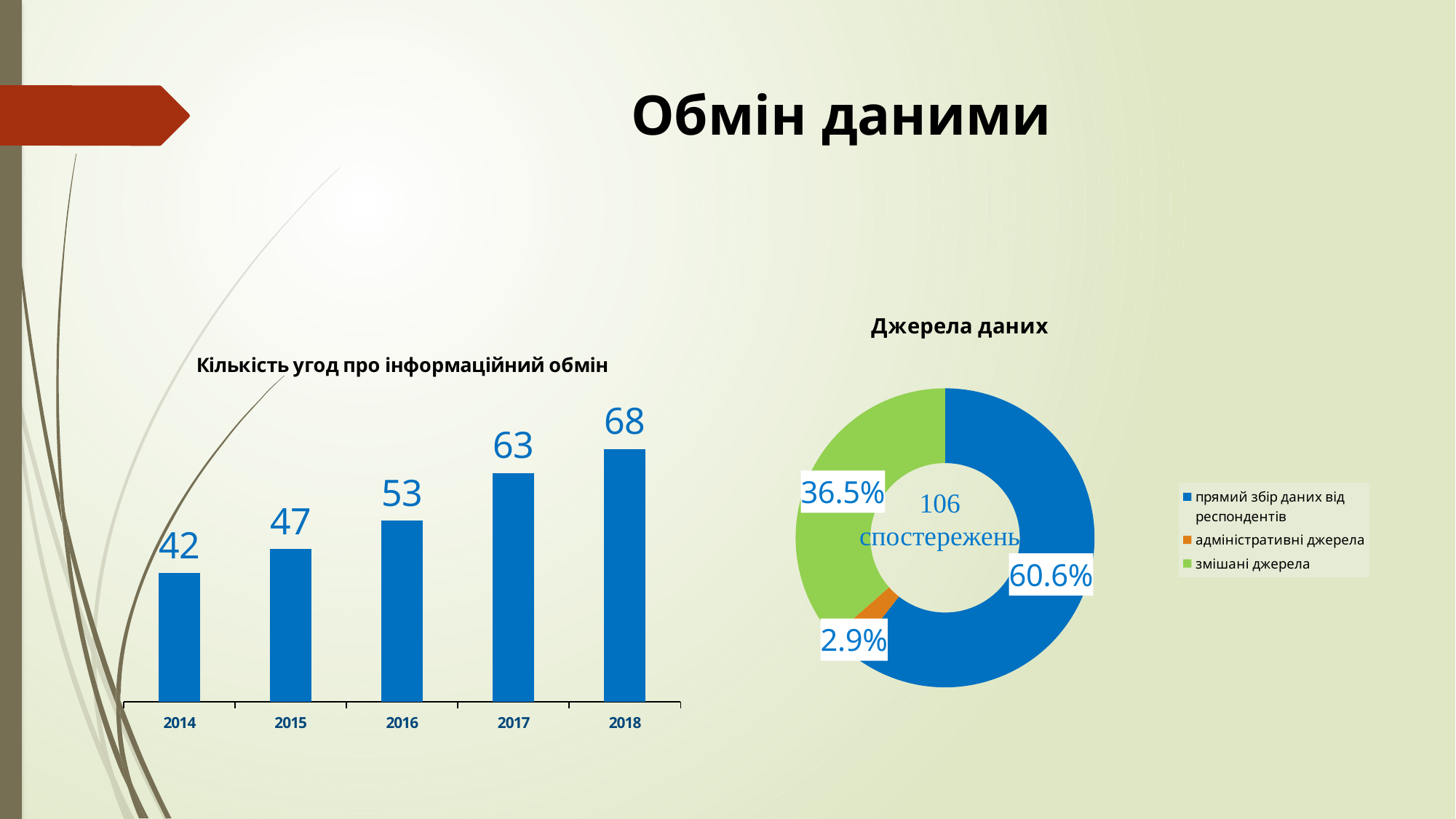
In the chart 'Джерела даних', what number of observations is written in the centre of the doughnut? 106 спостережень What kind of chart is 'Кількість угод про інформаційний обмін'? bar chart In the chart 'Кількість угод про інформаційний обмін', which is larger, the value for 2015 or the value for 2017? 2017 In the chart 'Джерела даних', which source has the smallest share? адміністративні джерела In the chart 'Джерела даних', what share is labelled for 'змішані джерела'? 36.5% In the chart 'Джерела даних', how many entries does the legend list? 3 In the chart 'Кількість угод про інформаційний обмін', do the values rise or fall from 2014 to 2018? rise In the chart 'Кількість угод про інформаційний обмін', how many years are shown on the x axis? 5 In the chart 'Кількість угод про інформаційний обмін', which year has the highest value? 2018 In the chart 'Кількість угод про інформаційний обмін', what is the difference between the values for 2018 and 2014? 26 In the chart 'Кількість угод про інформаційний обмін', which year has the lowest value? 2014 In the chart 'Кількість угод про інформаційний обмін', what is the value for 2016? 53